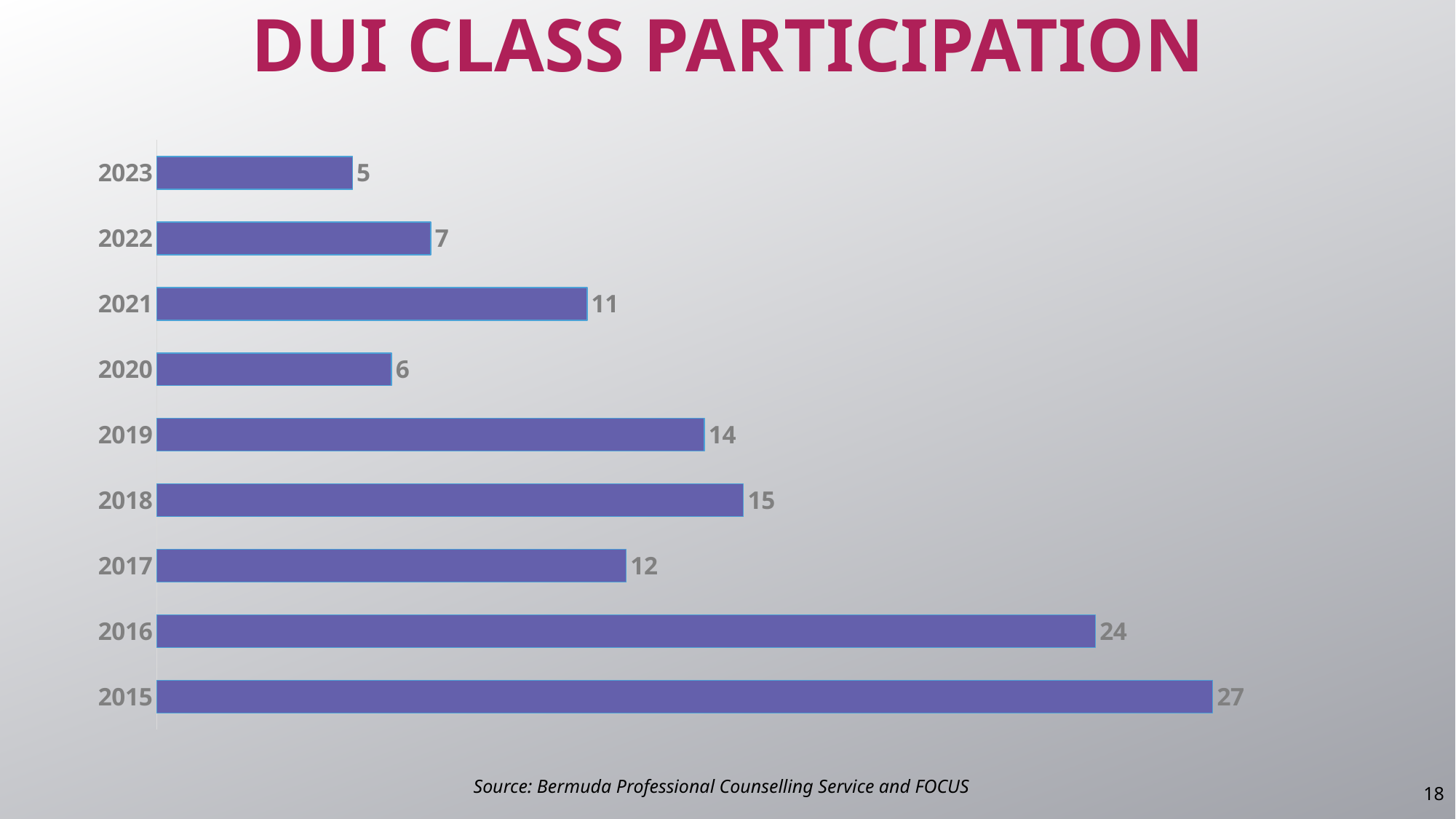
What source is cited for the chart data? Bermuda Professional Counselling Service and FOCUS Which year has the highest DUI class participation? 2015 Which year has the lowest DUI class participation? 2023 What is the title of the chart on the slide? DUI CLASS PARTICIPATION What is the difference in DUI class participation between 2018 and 2019? 1 What kind of chart is shown on the slide? Bar chart What is the difference in DUI class participation between 2016 and 2017? 12 What is the DUI class participation value for 2021? 11 What is the DUI class participation value for 2015? 27 How many years are shown in the chart? 9 Which year had higher DUI class participation, 2020 or 2022? 2022 What is the DUI class participation value for 2023? 5